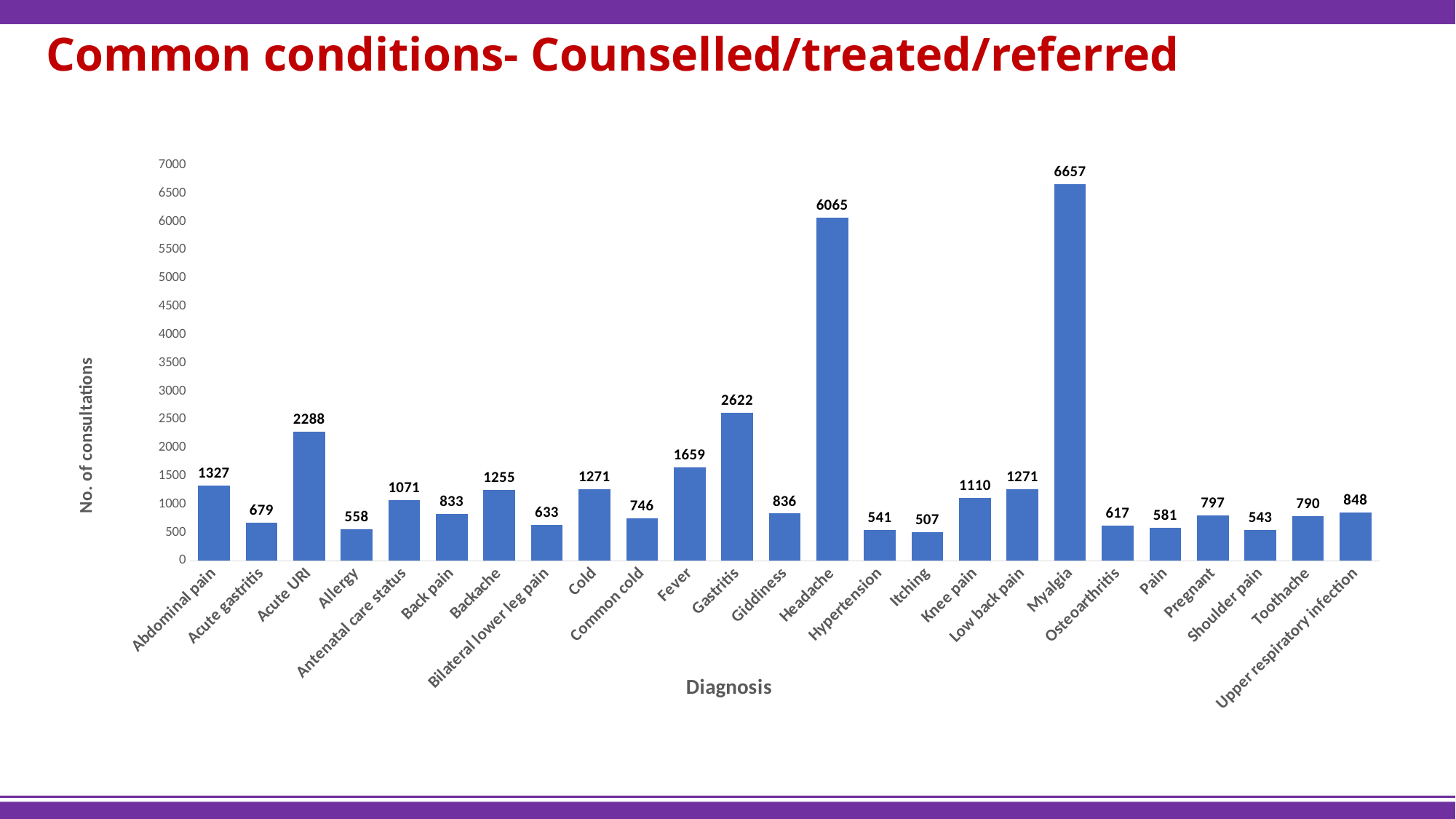
Is the value for Gastritis greater or less than 2500? greater Which diagnosis has the lowest number of consultations? Itching Which diagnosis has the highest number of consultations? Myalgia What is the difference between the values for Myalgia and Headache? 592 Which has more consultations, Fever or Abdominal pain? Fever How many consultations are shown for Headache? 6065 What is the title of the slide? Common conditions- Counselled/treated/referred What is the label of the y axis? No. of consultations What is the number of consultations for Gastritis? 2622 What is the value for Acute URI? 2288 What kind of chart is shown on the slide? bar chart How many diagnosis categories are shown on the x axis? 25